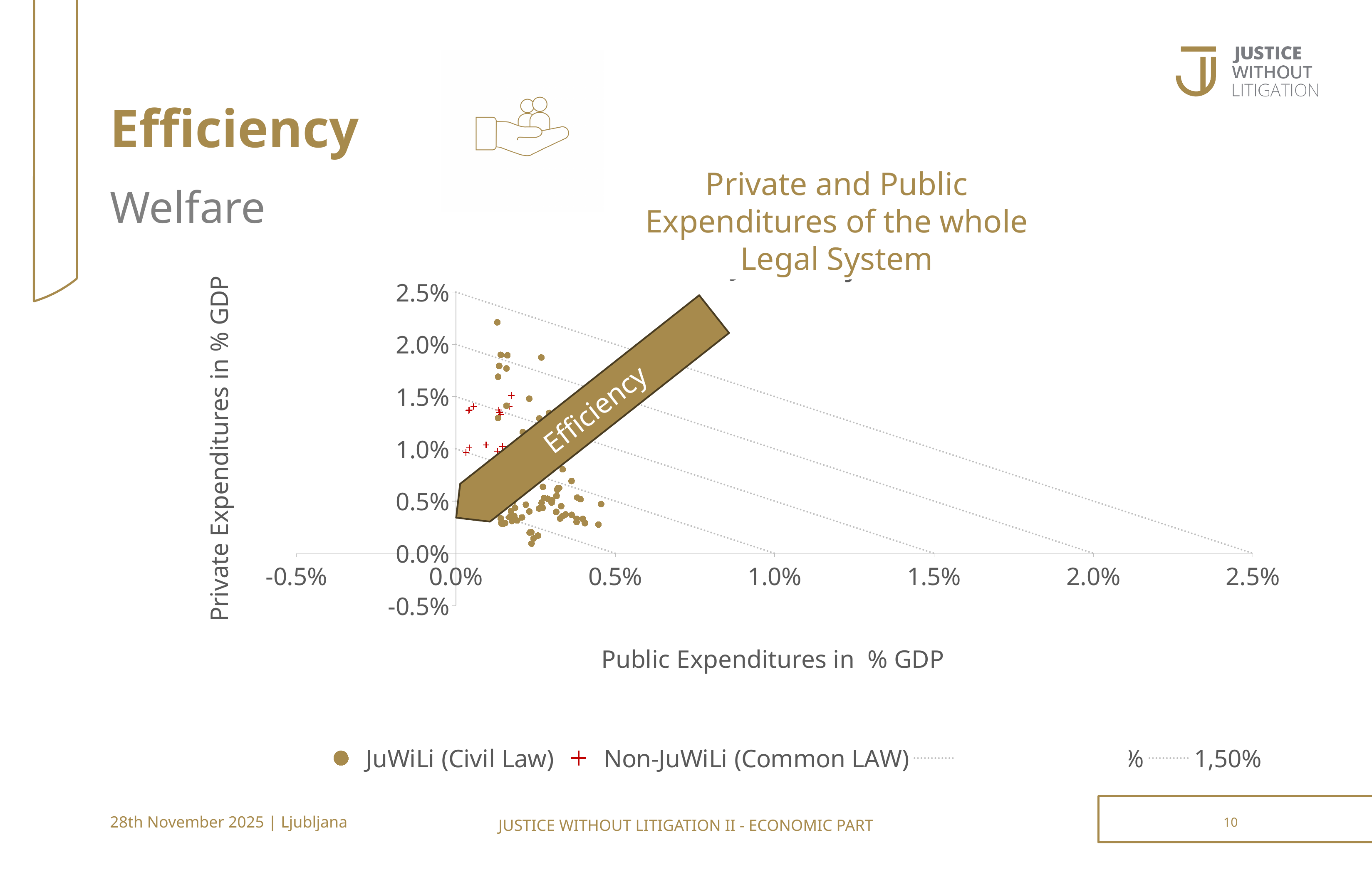
What is the lowest value shown on the x axis? -0.5% Which legend entry is marked with a red plus sign? Non-JuWiLi (Common LAW) Are the Non-JuWiLi (Common LAW) points plotted at public expenditures greater or less than 0.5%? less What kind of chart is shown on the slide? scatter chart Is the private expenditure of the highest JuWiLi (Civil Law) point greater or less than 2.0%? greater Are the Non-JuWiLi (Common LAW) points plotted at private expenditures greater or less than 2.0%? less Which series has the point with the highest private expenditure in the chart? JuWiLi (Civil Law) What is the highest value shown on the x axis (Public Expenditures in % GDP)? 2.5% What is the title of the chart? Private and Public Expenditures of the whole Legal System What is the highest value shown on the y axis (Private Expenditures in % GDP)? 2.5%